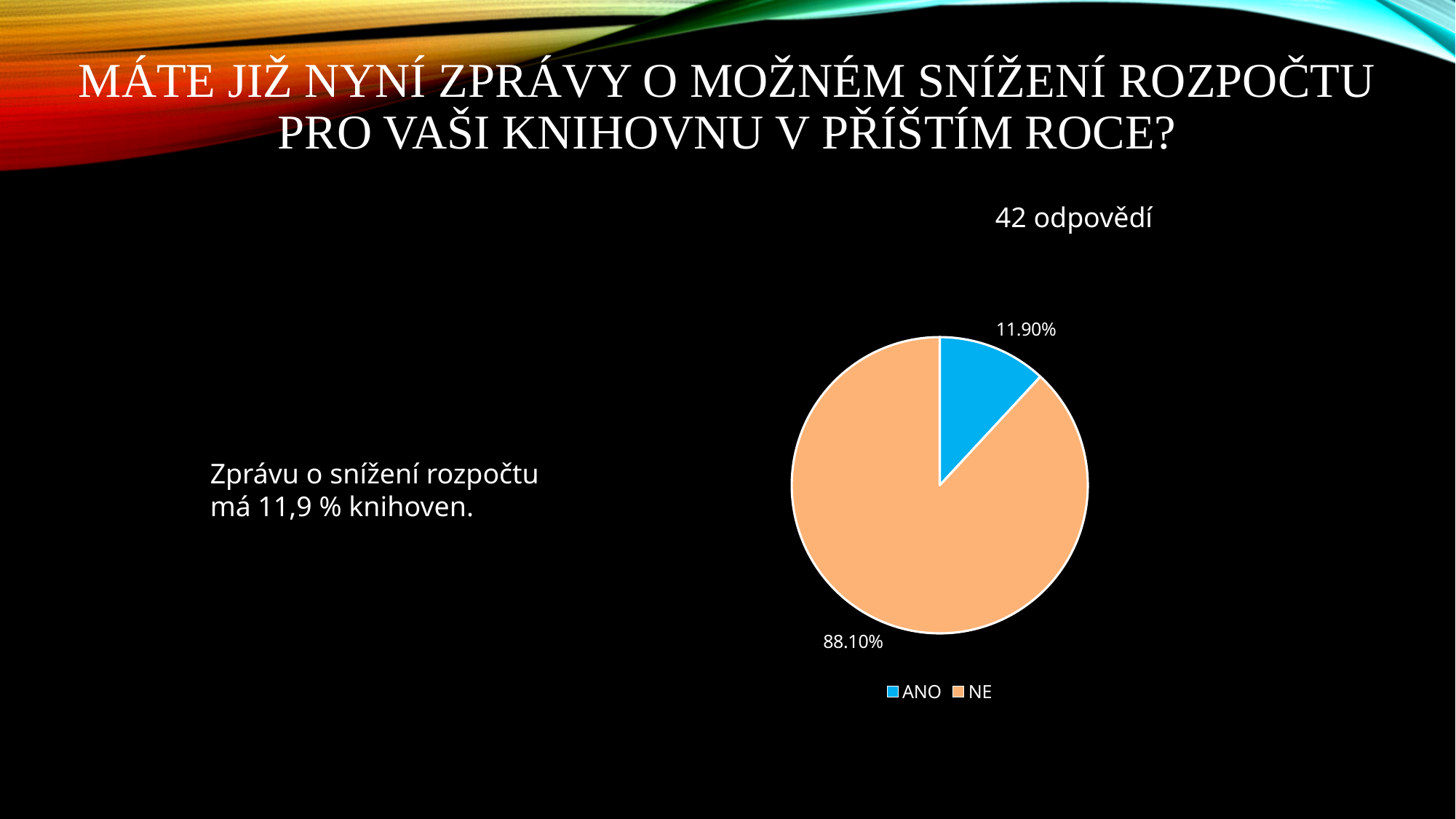
What colour is the NE slice? orange How many categories does the pie chart show? 2 Which is larger, the slice for ANO or the slice for NE? NE Is the share for NE greater or less than 50%? greater How many entries does the legend list? 2 What colour is the ANO slice? blue Which category has the largest slice of the pie? NE Which category has the smallest slice of the pie? ANO What share of the pie does ANO have? 11.90% What is the difference in percentage points between the NE slice and the ANO slice? 76.20% What share of the pie does NE have? 88.10% What kind of chart is shown on the slide? pie chart